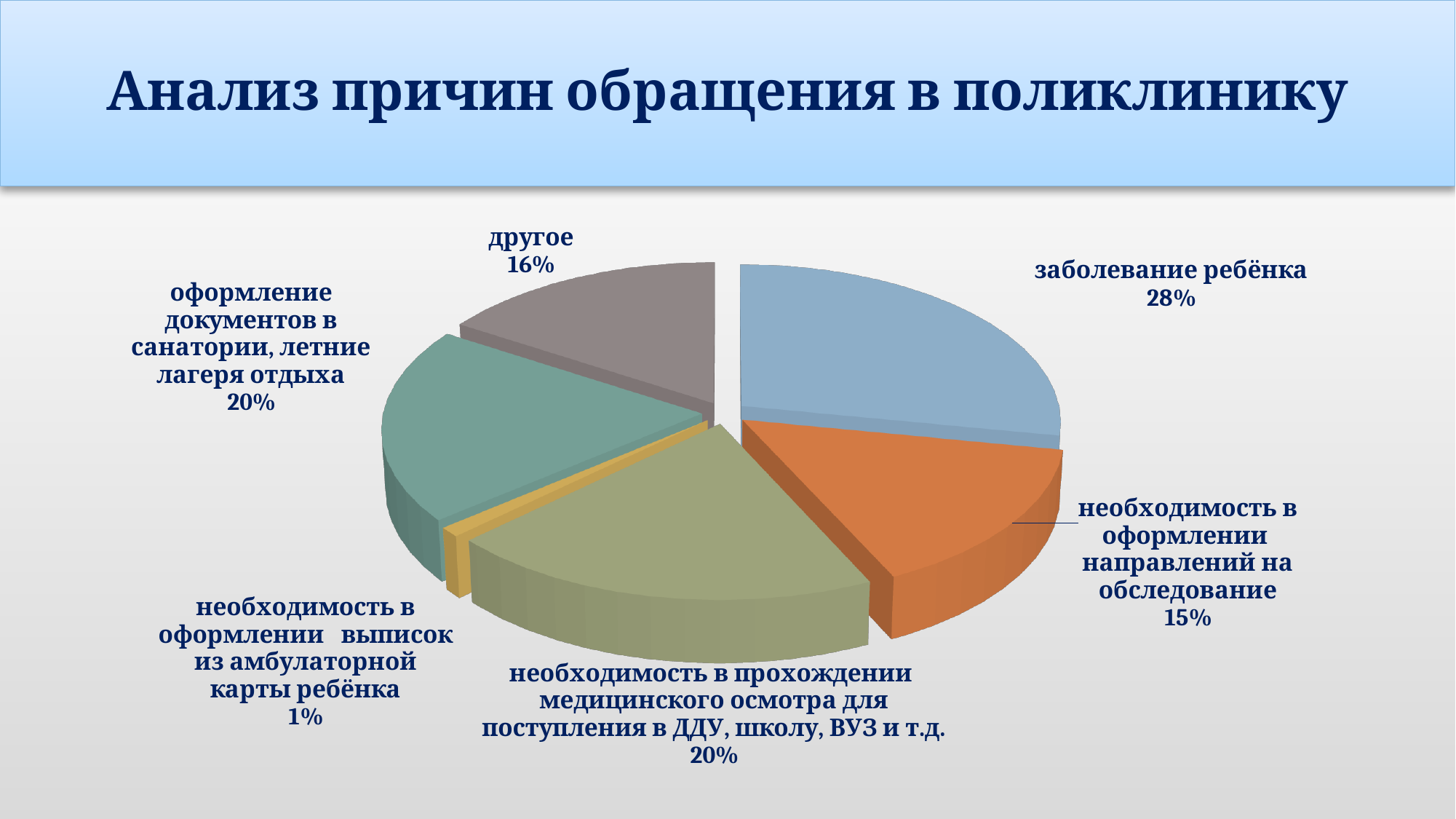
What is the value shown for "другое"? 16% What is the title of the chart on the slide? Анализ причин обращения в поликлинику Which category has the largest share of the pie? заболевание ребёнка Which is larger: the share for "другое" or the share for "необходимость в оформлении направлений на обследование"? другое What share of the pie is labelled "заболевание ребёнка"? 28% What is the value shown for "необходимость в оформлении выписок из амбулаторной карты ребёнка"? 1% Which category has the smallest share of the pie? необходимость в оформлении выписок из амбулаторной карты ребёнка What kind of chart is shown on the slide? pie chart What is the difference between the share for "заболевание ребёнка" and the share for "другое"? 12% What is the value shown for "необходимость в оформлении направлений на обследование"? 15% How many slices does the pie chart have? 6 What is the value shown for "оформление документов в санатории, летние лагеря отдыха"? 20%